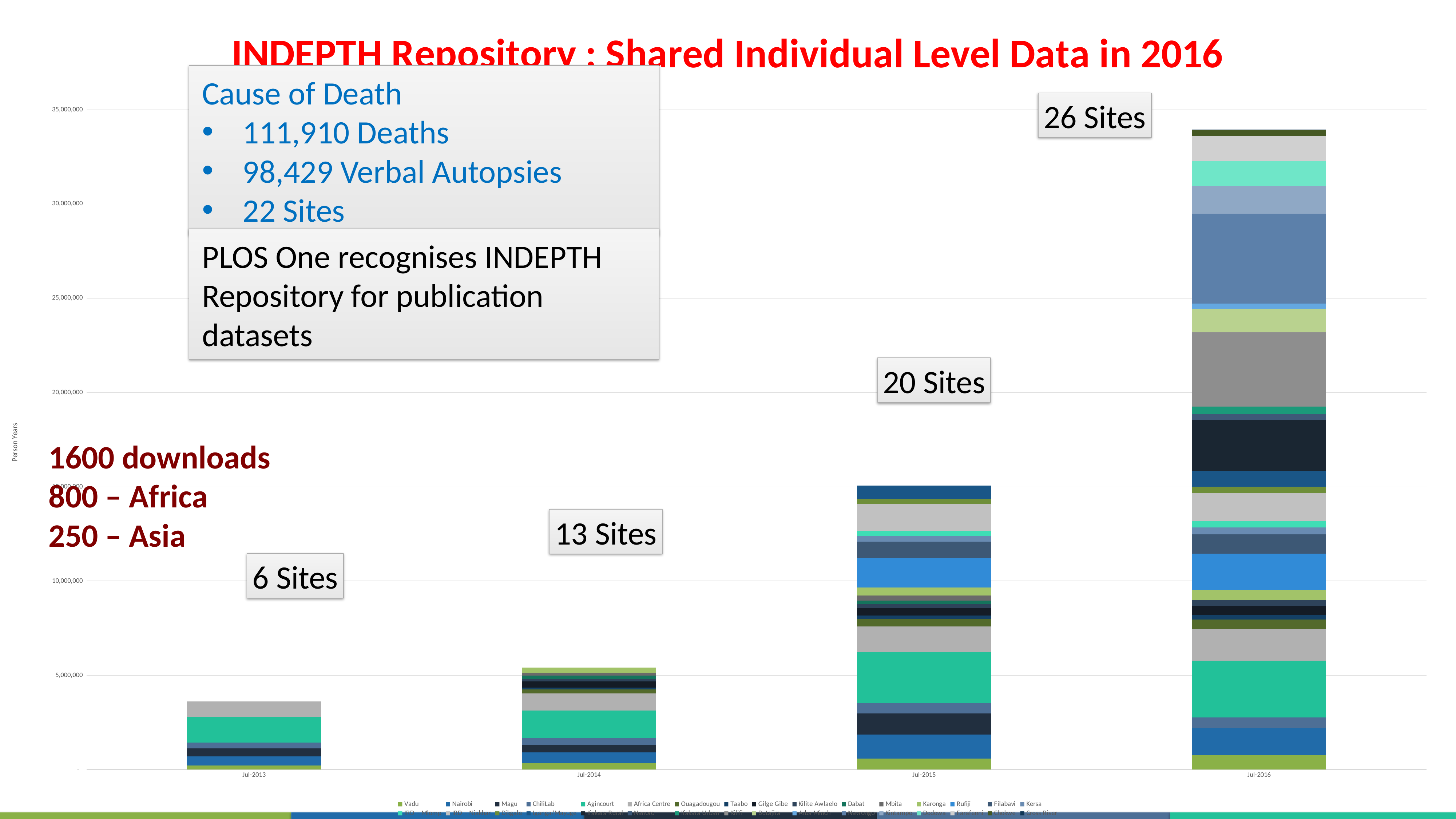
Which bar is taller, Jul-2014 or Jul-2015? Jul-2015 Is the total for Jul-2016 greater or less than 30,000,000 person years? greater What kind of chart is shown on the slide? stacked bar chart Which time point has the highest total person years? Jul-2016 Do the total person years rise or fall from Jul-2013 to Jul-2016? rise How many sites does the label above the Jul-2016 bar indicate? 26 Sites Is the total for Jul-2015 greater or less than 10,000,000 person years? greater Which time point has the lowest total person years? Jul-2013 How many bars (time points) are plotted along the x axis? 4 How many sites does the label above the Jul-2014 bar indicate? 13 Sites Is the total for Jul-2013 greater or less than 5,000,000 person years? less What is the label on the vertical axis of the chart? Person Years